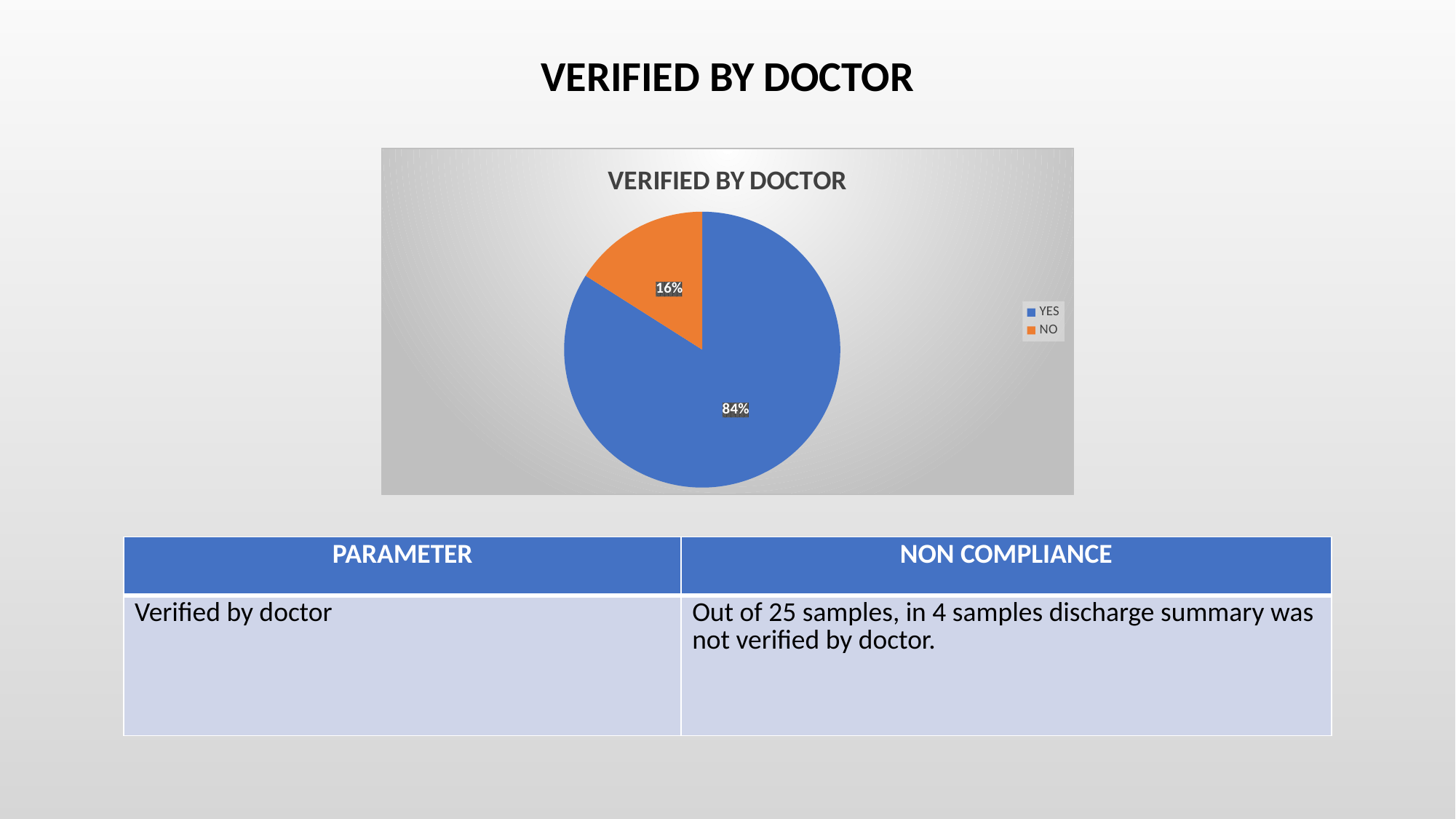
Which category has the largest share of the pie chart? YES What is the title of the chart? VERIFIED BY DOCTOR Which category has the smallest share of the pie chart? NO How many entries does the chart legend list? 2 What share of the pie does the NO slice represent? 16% Which slice is larger, YES or NO? YES What percentage of the pie chart is labelled NO? 16% How many slices does the pie chart have? 2 What is the difference in percentage points between the YES and NO slices? 68 What percentage of the pie chart is labelled YES? 84% What kind of chart is shown on the slide? Pie chart What colour is the YES slice in the pie chart? Blue